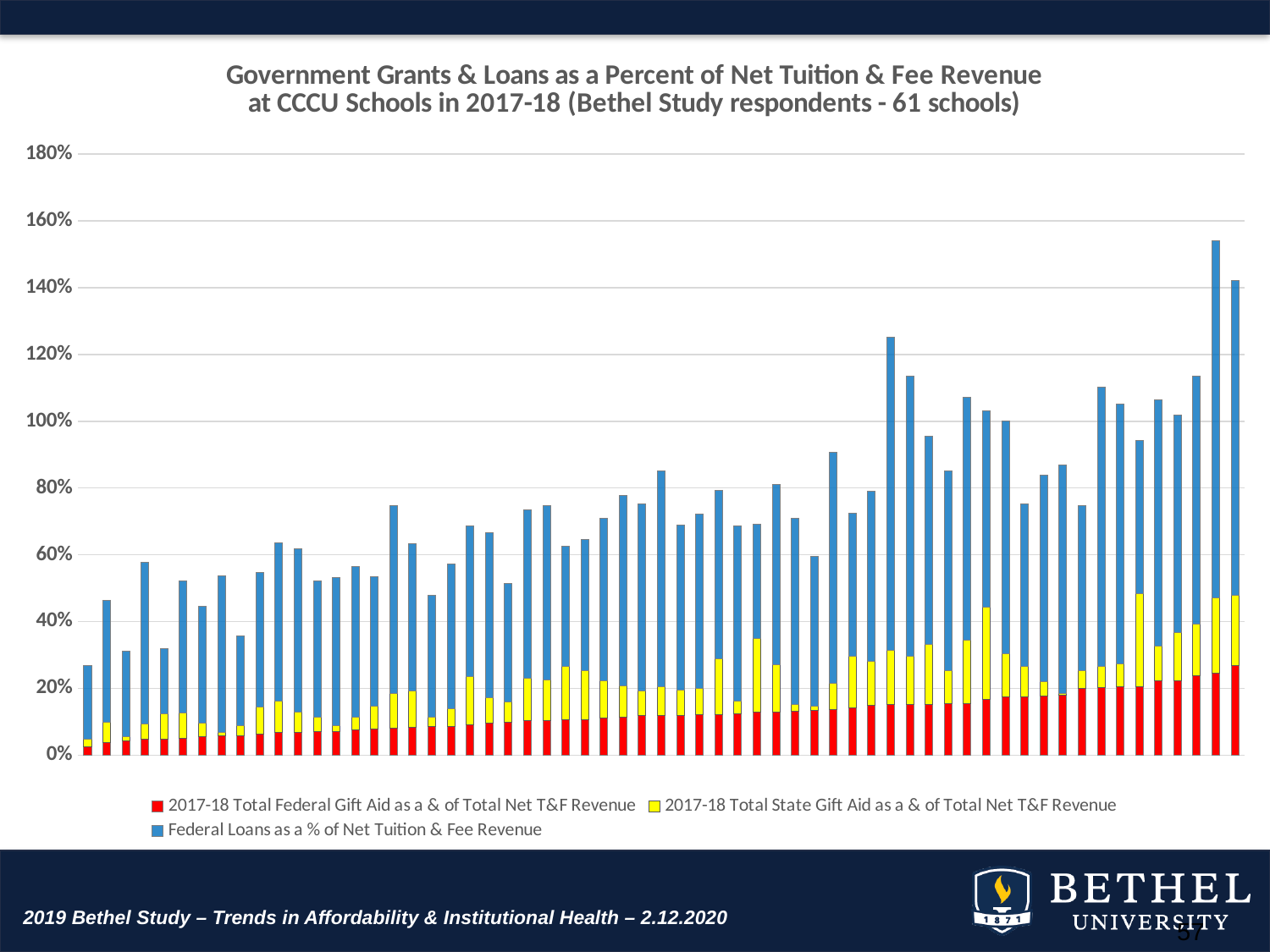
How many series does the legend list? 3 How many schools (bars) are represented in the chart? 61 Which series is shown in yellow in the legend? 2017-18 Total State Gift Aid as a & of Total Net T&F Revenue Which is larger for the tallest bar: the blue Federal Loans segment or the red Federal Gift Aid segment? Federal Loans (blue) Do the red (Federal Gift Aid) segments generally rise or fall moving from left to right along the x axis? rise Is the total of the leftmost bar greater or less than 40%? less Is the total of the rightmost bar greater or less than 120%? greater Is the value of the tallest bar greater or less than 140%? greater What is the highest value shown on the vertical axis? 180% What kind of chart is shown on the slide? Stacked bar chart